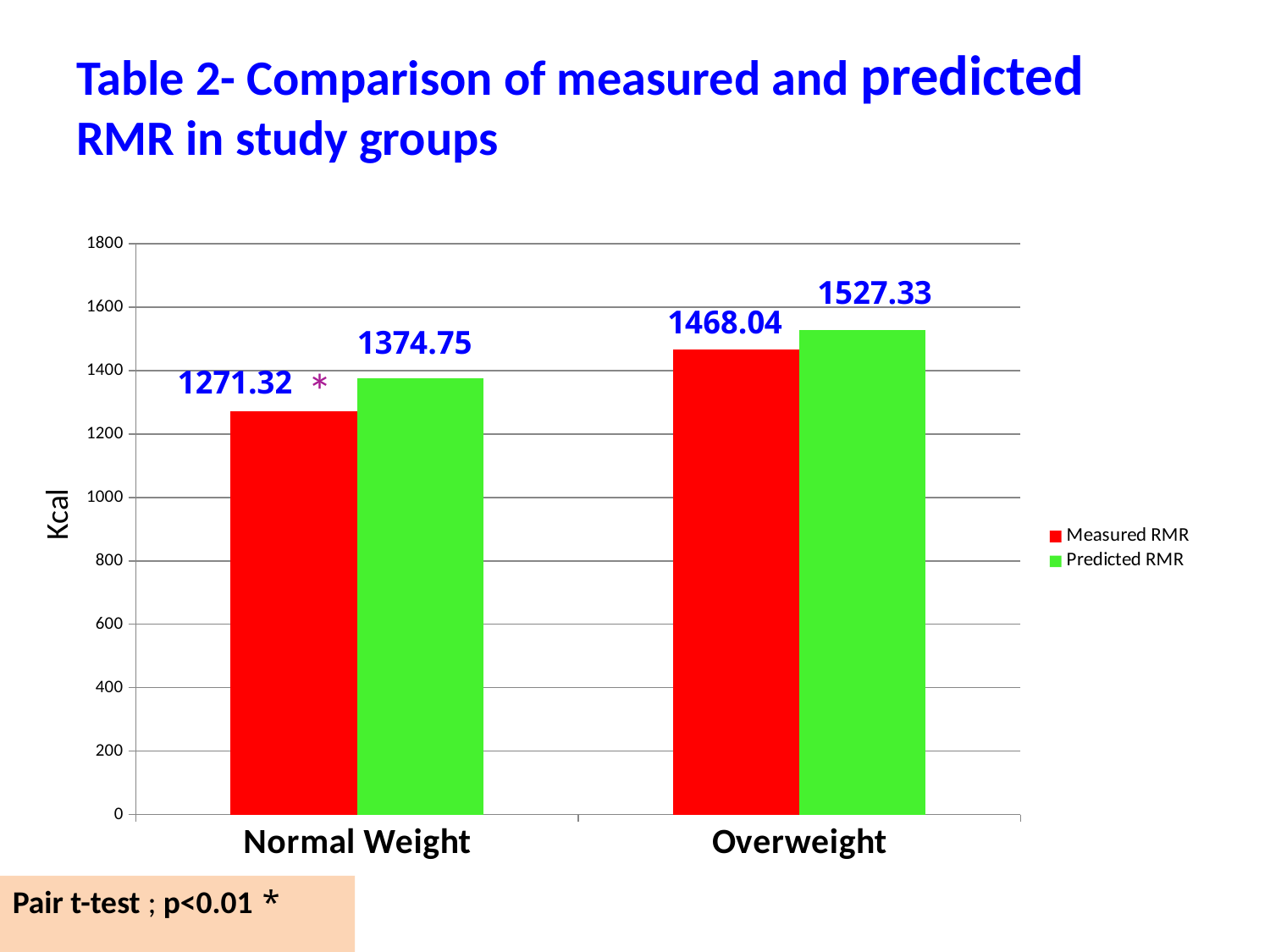
What is the Predicted RMR value for the Overweight group? 1527.33 What is the Predicted RMR value for the Normal Weight group? 1374.75 What is the label on the vertical axis of the chart? Kcal What is the Measured RMR value for the Normal Weight group? 1271.32 What is the difference between Predicted RMR and Measured RMR for the Overweight group? 59.29 How many series does the legend list? 2 Which is larger for the Normal Weight group, Measured RMR or Predicted RMR? Predicted RMR Which bar has the highest value on the chart? Predicted RMR for Overweight What is the difference between Predicted RMR and Measured RMR for the Normal Weight group? 103.43 What kind of chart is shown on the slide? Bar chart What is the Measured RMR value for the Overweight group? 1468.04 Which bar has the lowest value on the chart? Measured RMR for Normal Weight